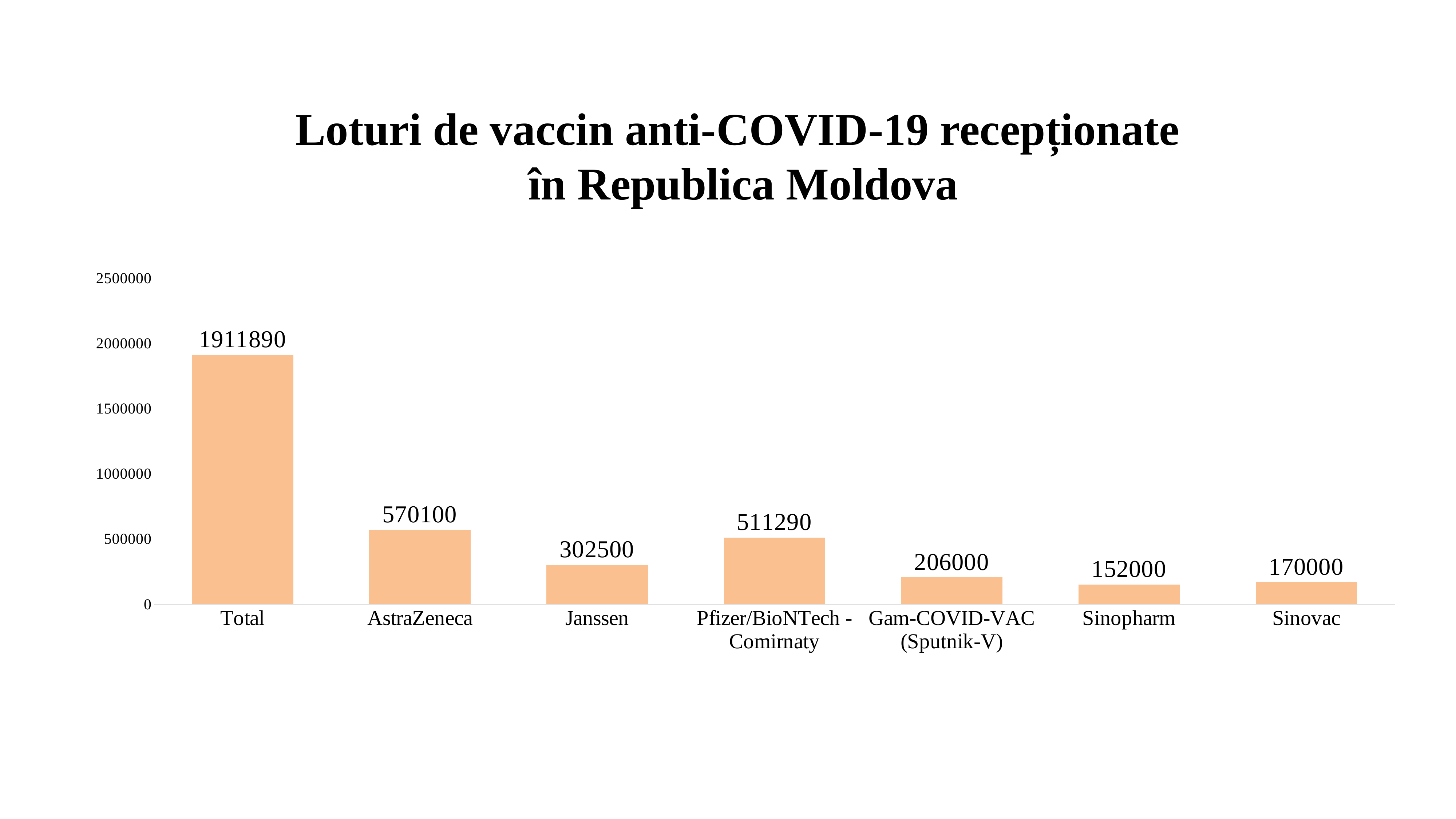
What is the value for Gam-COVID-VAC (Sputnik-V)? 206000 How many bars are shown in the chart? 7 Which is larger, the value for Sinovac or the value for Sinopharm? Sinovac Is the value for Janssen greater or less than 500000? less What is the value shown for the Total bar? 1911890 What is the difference between the values for AstraZeneca and Pfizer/BioNTech - Comirnaty? 58810 What is the value for Pfizer/BioNTech - Comirnaty? 511290 Excluding the Total bar, which vaccine has the highest value? AstraZeneca What type of chart is shown on the slide? bar chart What is the value for AstraZeneca? 570100 What is the value for Janssen? 302500 Which category has the lowest value? Sinopharm